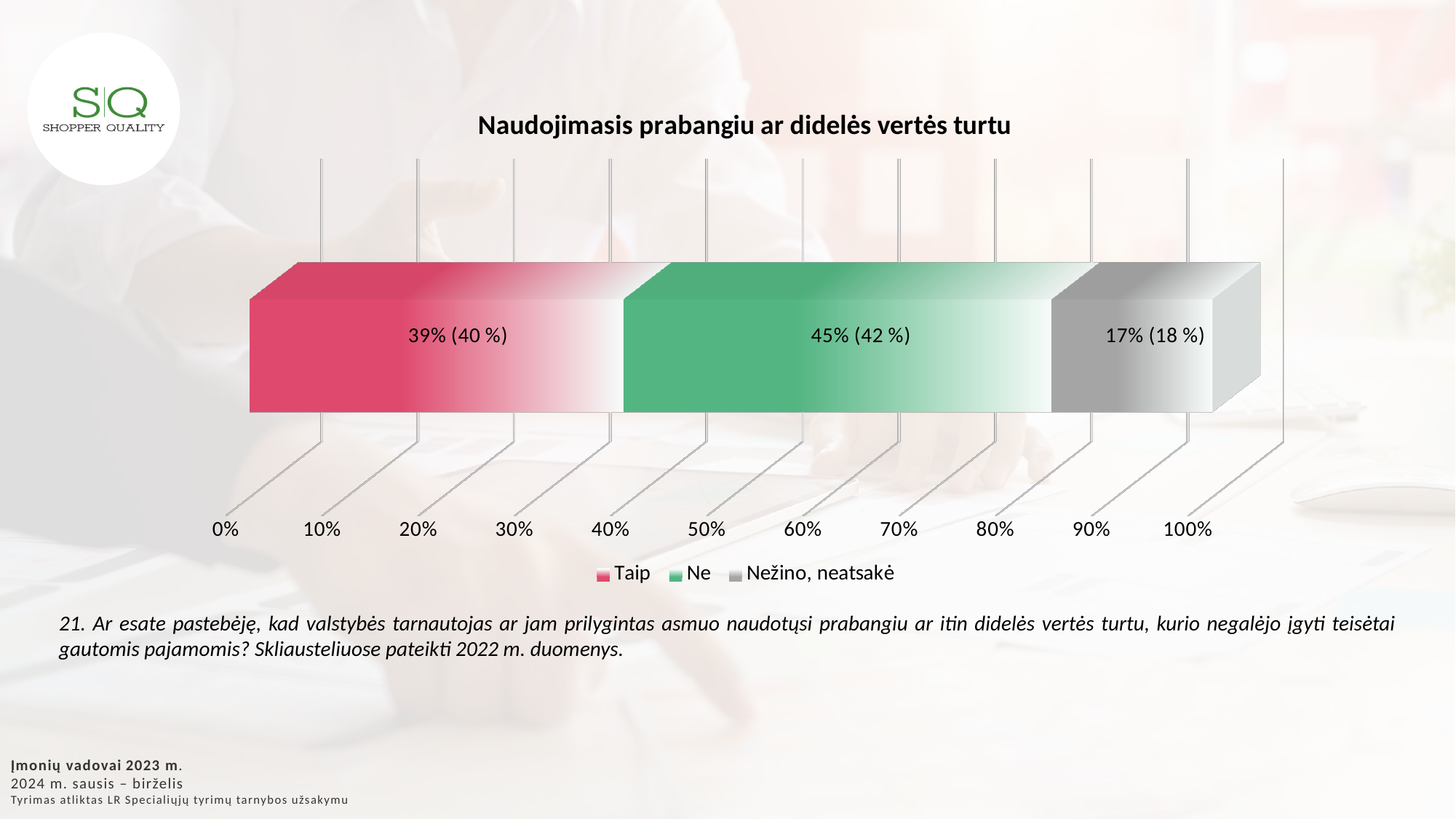
What is the value for Nežino, neatsakė? 17% What was the 2022 value for Ne, shown in parentheses? 42 % How many series does the legend list? 3 What is the title of the chart? Naudojimasis prabangiu ar didelės vertės turtu Which series has the lowest value? Nežino, neatsakė Which is larger, the value for Taip or the value for Nežino, neatsakė? Taip Which series has the highest value? Ne What is the difference between the values for Ne and Taip? 6% What kind of chart is shown on the slide? Stacked bar chart What is the value for Taip? 39% What was the 2022 value for Taip, shown in parentheses? 40 % What is the value for Ne? 45%